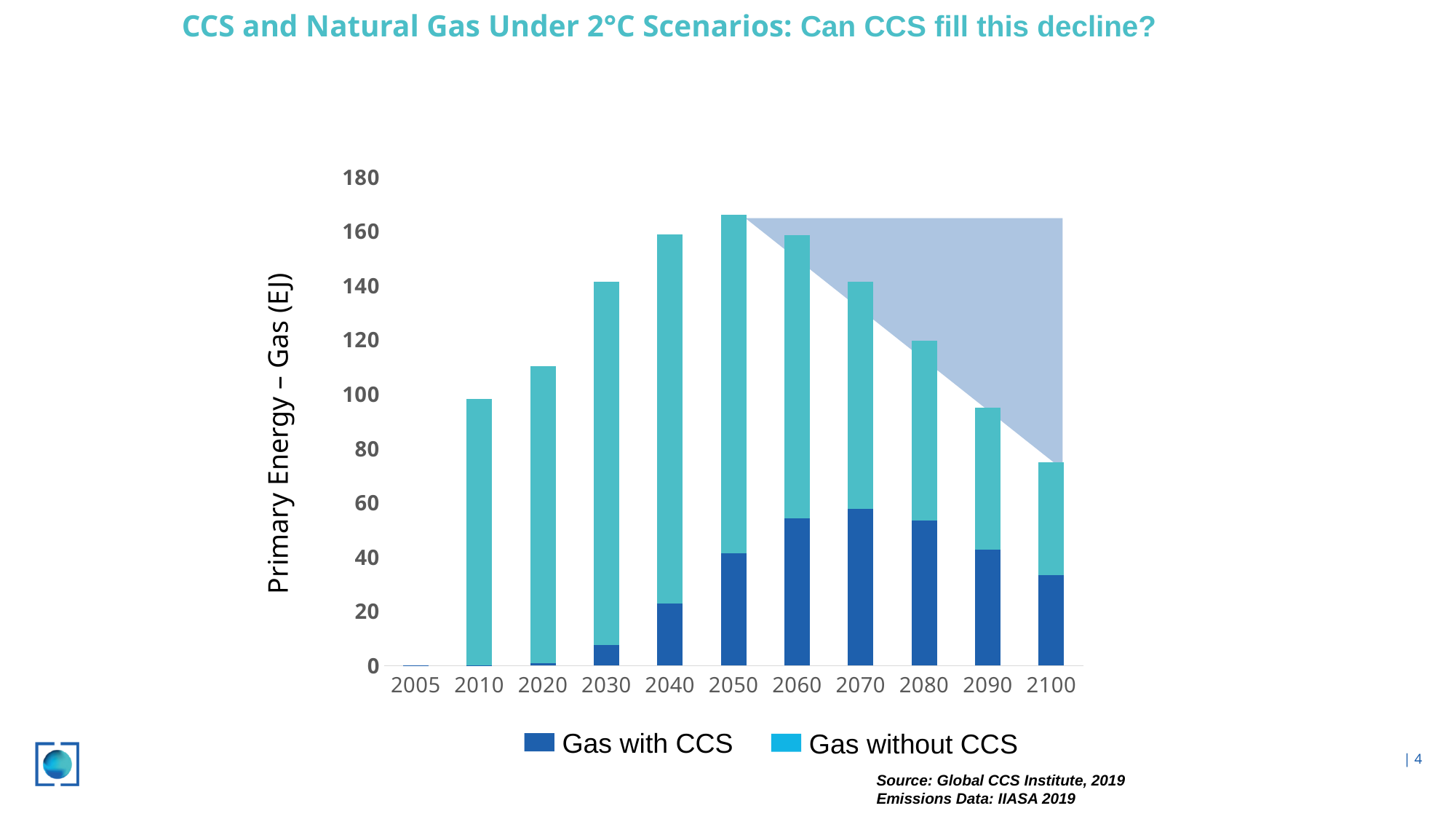
Which year has the highest total bar? 2050 Which is larger, the total bar for 2020 or the total bar for 2080? 2080 Is the total bar for 2090 greater or less than 100? less What kind of chart is shown on the slide? Stacked bar chart How many series does the legend list? 2 How many year categories are shown on the x axis? 11 What is the label on the vertical axis? Primary Energy – Gas (EJ) Do the total bar heights rise or fall from 2050 to 2100? fall Is the Gas with CCS value for 2040 greater or less than 20? greater Which year has the lowest total bar? 2005 Is the total bar for 2050 greater or less than 160? greater